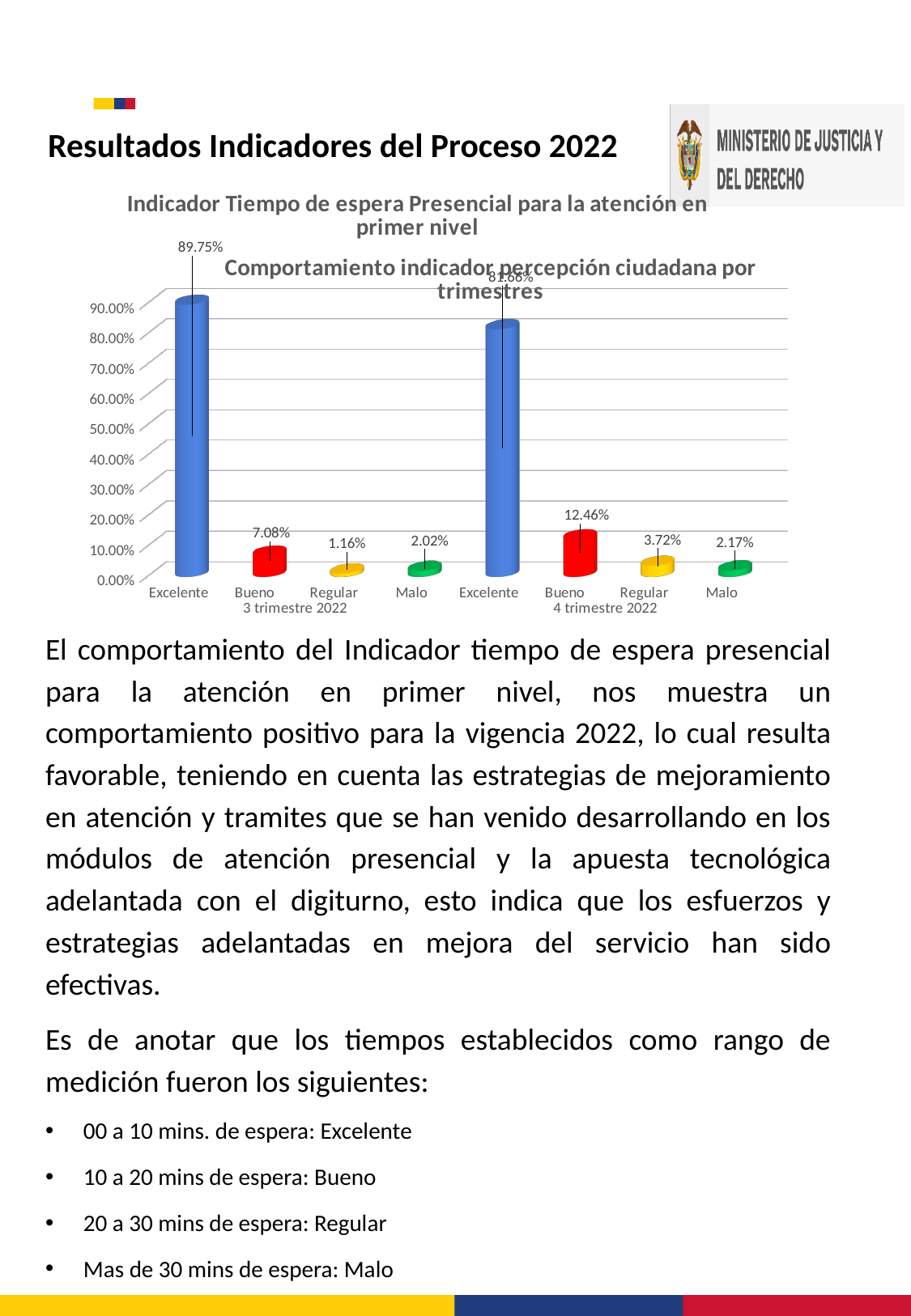
What kind of chart is shown on the slide? Bar chart What is the value for Malo in 4 trimestre 2022? 2.17% What is the difference between Bueno in 4 trimestre 2022 and Bueno in 3 trimestre 2022? 5.38% What is the value for Excelente in 3 trimestre 2022? 89.75% Which is larger: Malo in 3 trimestre 2022 or Regular in 4 trimestre 2022? Regular in 4 trimestre 2022 What is the value for Regular in 4 trimestre 2022? 3.72% How many bars are plotted in the chart? 8 Which category has the lowest value in 3 trimestre 2022? Regular What is the value for Bueno in 4 trimestre 2022? 12.46% What is the value for Regular in 3 trimestre 2022? 1.16% Which category has the highest value in 3 trimestre 2022? Excelente Is the value for Excelente in 4 trimestre 2022 greater or less than 80.00%? greater